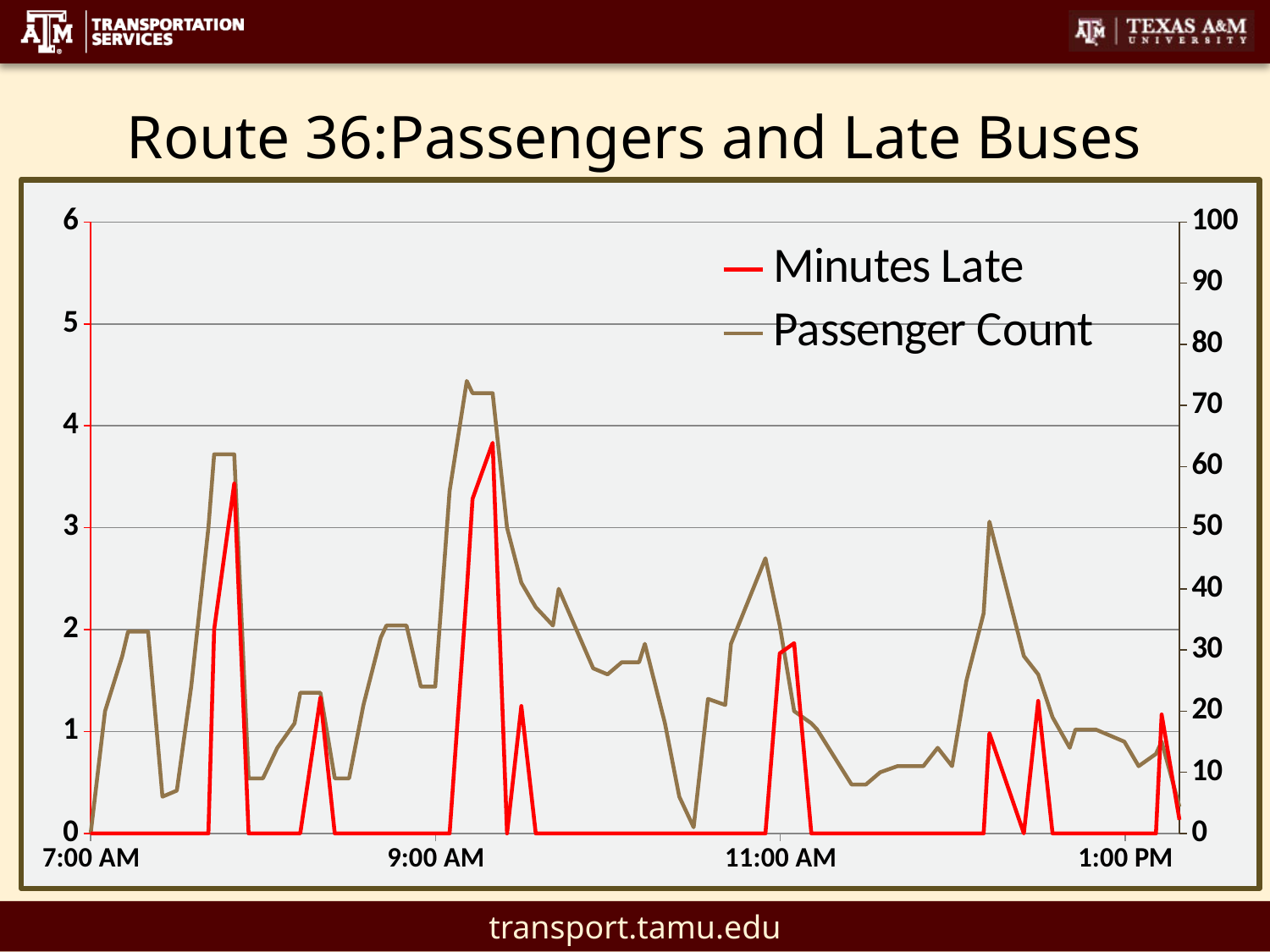
What is the highest value shown on the left vertical axis? 6 Is the Minutes Late value at 11:00 AM greater or less than 1 on the left axis? greater Which is higher: the Passenger Count peak just after 9:00 AM or the Passenger Count peak between 7:00 AM and 9:00 AM? the peak just after 9:00 AM How many series does the legend list? 2 Between which two labeled times on the x axis does the Minutes Late line reach its highest peak? 9:00 AM and 11:00 AM What kind of chart is shown on the slide? line chart Which series is drawn in red? Minutes Late Is the highest peak of the Passenger Count line greater or less than 60 on the right axis? greater What is the highest value shown on the right vertical axis? 100 Is the highest peak of the Minutes Late line greater or less than 3 on the left axis? greater